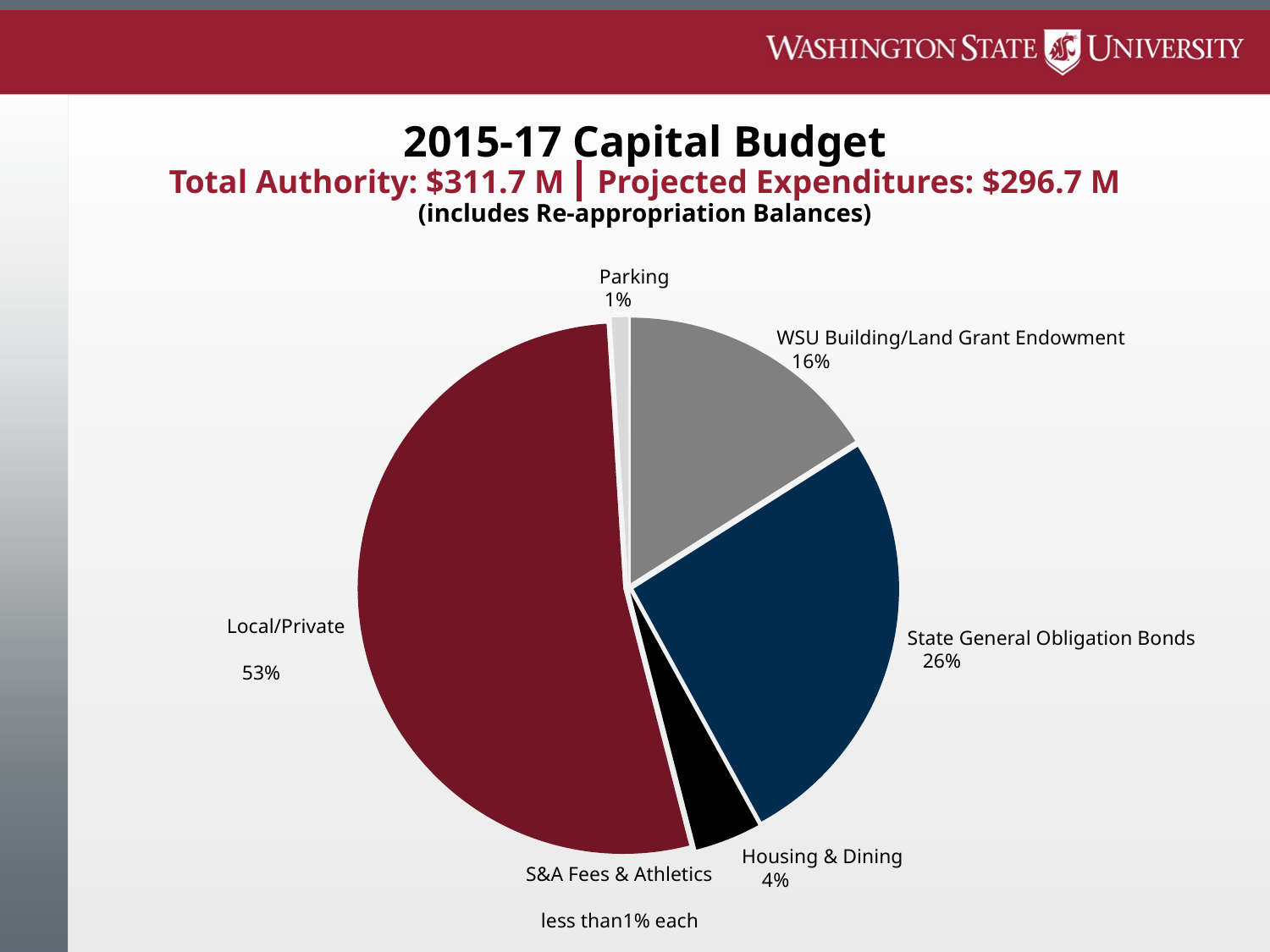
What percentage is shown for State General Obligation Bonds? 26% What percentage is shown for Parking? 1% How many labelled categories does the pie chart have? 6 Which category has the largest slice of the pie? Local/Private What is the difference in percentage points between WSU Building/Land Grant Endowment and Housing & Dining? 12 Which is larger, State General Obligation Bonds or WSU Building/Land Grant Endowment? State General Obligation Bonds What is the title of the chart on the slide? 2015-17 Capital Budget What percentage is shown for WSU Building/Land Grant Endowment? 16% What is the difference in percentage points between Local/Private and State General Obligation Bonds? 27 What kind of chart is shown on the slide? Pie chart What percentage is shown for Housing & Dining? 4% What share of the pie does Local/Private represent? 53%